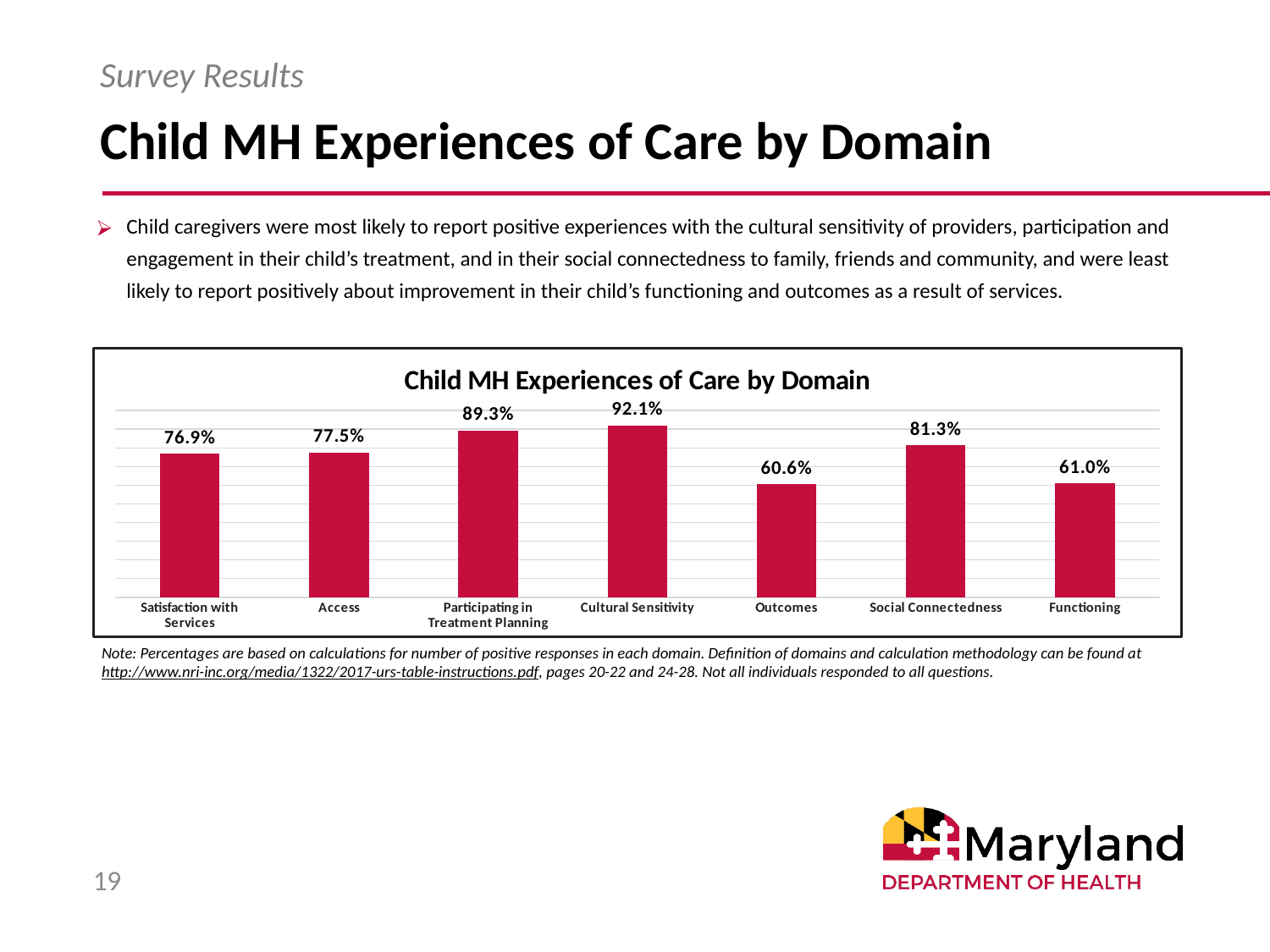
Which domain has the lowest value? Outcomes How many domains are shown in the chart? 7 What kind of chart is shown on the slide? Bar chart What is the difference between the values for Participating in Treatment Planning and Access? 11.8% What is the value for Satisfaction with Services? 76.9% What is the value for Outcomes? 60.6% Which is larger, the value for Social Connectedness or the value for Access? Social Connectedness What is the value for Social Connectedness? 81.3% Which domain has the highest value? Cultural Sensitivity What is the value for Cultural Sensitivity? 92.1% What is the difference between the values for Cultural Sensitivity and Outcomes? 31.5% What is the title of the chart? Child MH Experiences of Care by Domain